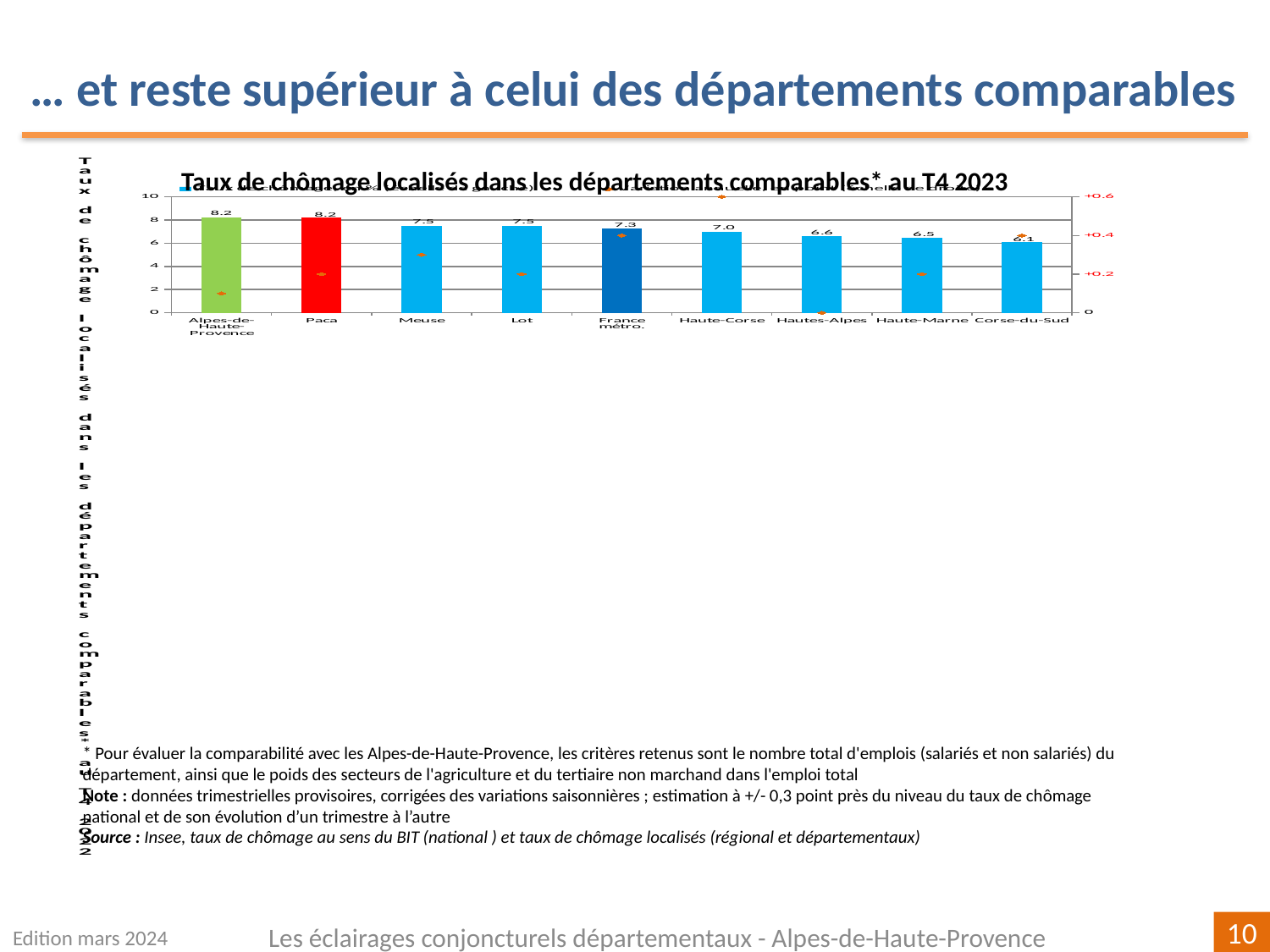
What is the difference between the values for Alpes-de-Haute-Provence and Corse-du-Sud? 2.1 How many categories are shown on the x axis? 9 What is the difference between the values for Hautes-Alpes and Haute-Marne? 0.1 What is the value shown for Corse-du-Sud? 6.1 What is the unemployment rate shown for Meuse? 7.5 Which category has the lowest bar? Corse-du-Sud What kind of chart is this? bar chart What is the value shown for France métro.? 7.3 Is the value for Hautes-Alpes greater or less than 8? less Do the bar values rise or fall from left to right along the x axis? fall Which is larger, the value for Lot or the value for Haute-Corse? Lot What is the value shown for Haute-Corse? 7.0